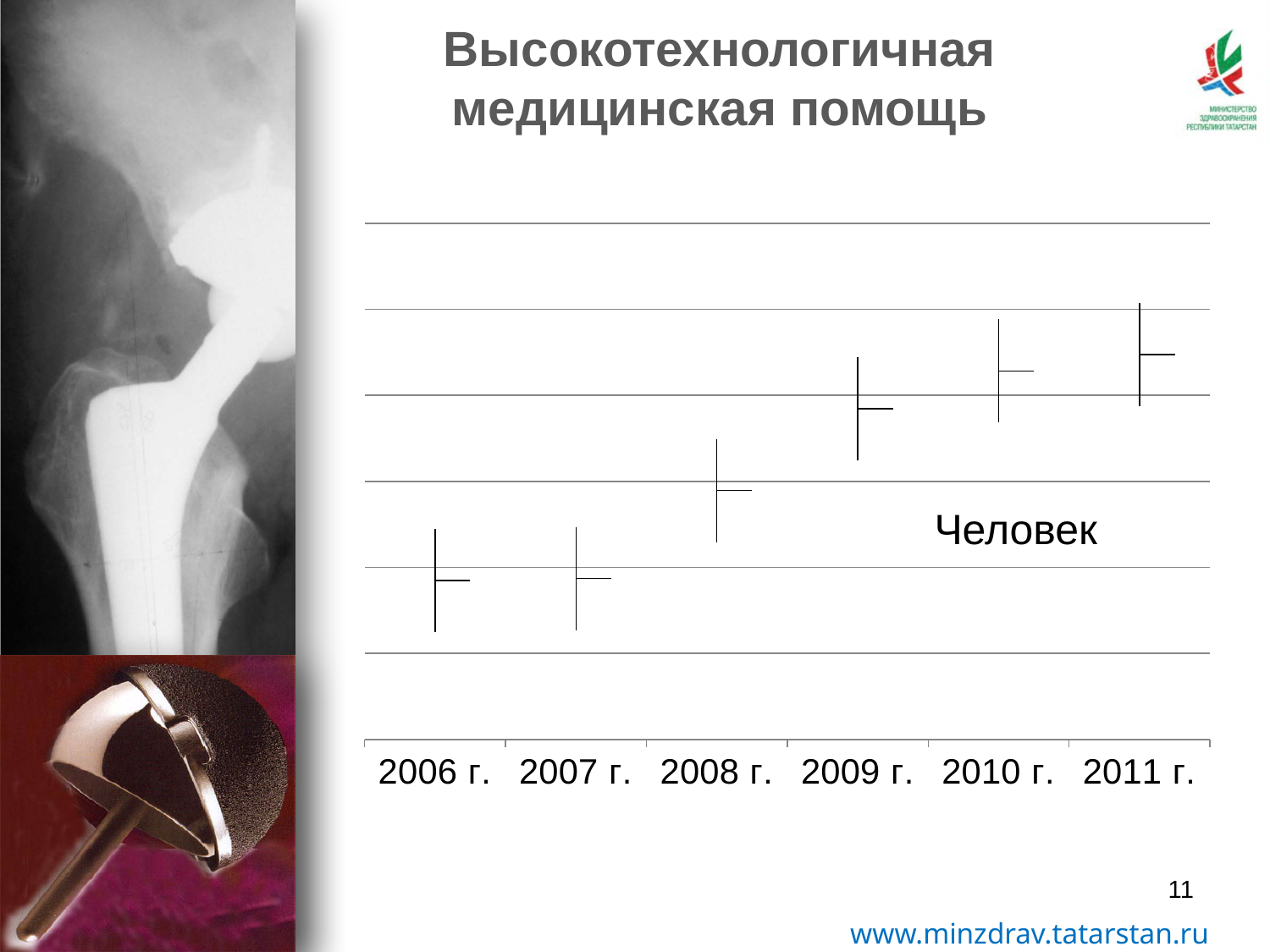
How many years are shown on the x axis of the chart? 6 What unit label is written inside the chart area? Человек What is the first year shown on the x axis of the chart? 2006 г. Which is higher on the chart, the value for 2008 г. or the value for 2006 г.? 2008 г. Which is higher on the chart, the value for 2011 г. or the value for 2009 г.? 2011 г. Which is higher on the chart, the value for 2009 г. or the value for 2008 г.? 2009 г. Do the values on the chart rise or fall from 2006 г. to 2011 г.? rise Which year has the highest value on the chart? 2011 г.